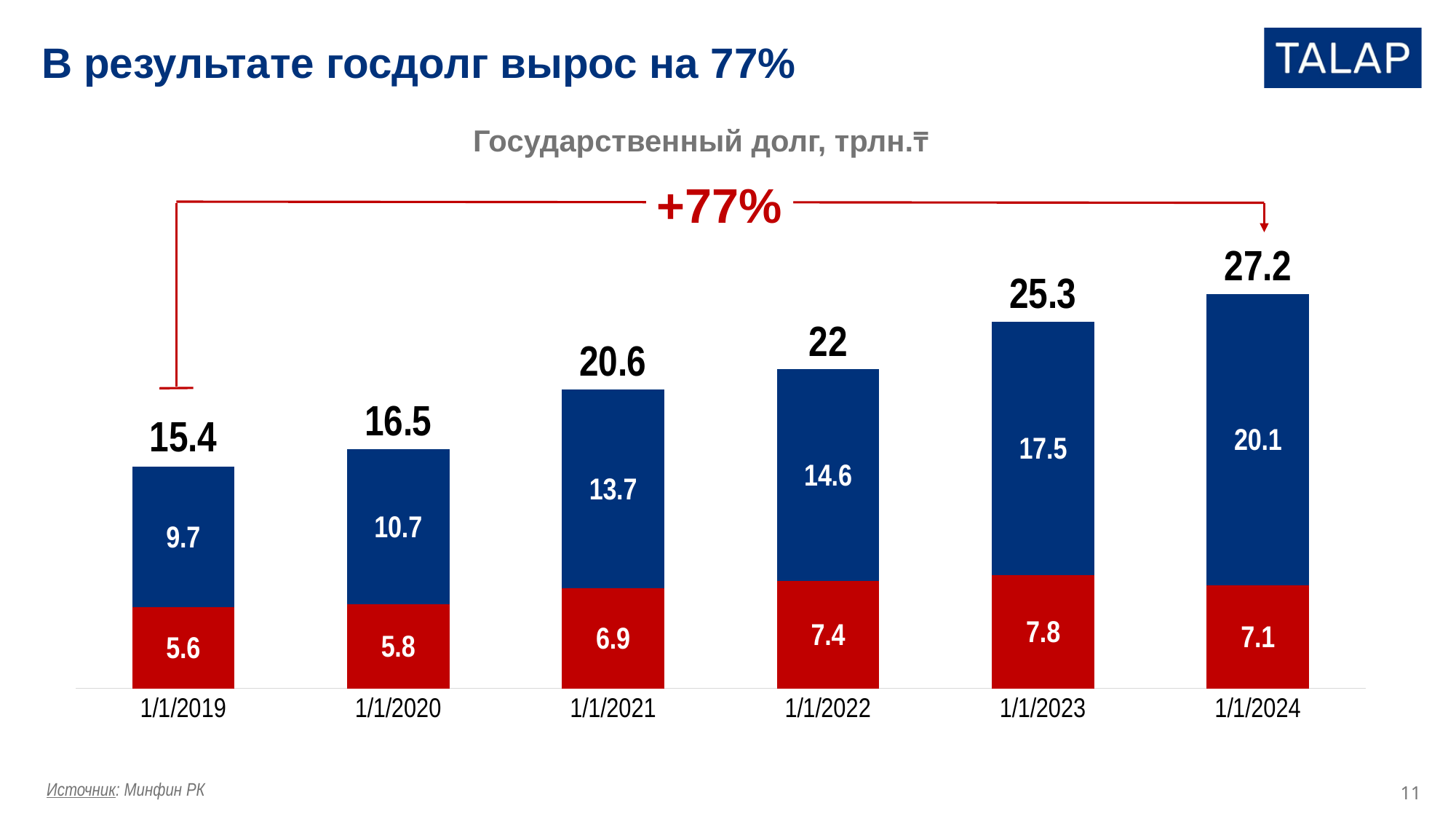
What is the title of the chart? Государственный долг, трлн.₸ Which is larger, the red segment for 1/1/2023 or the red segment for 1/1/2024? 1/1/2023 How many dates are shown on the x axis? 6 What is the value of the blue segment for 1/1/2021? 13.7 Which date has the lowest total government debt? 1/1/2019 Do the total values rise or fall from 1/1/2019 to 1/1/2024? Rise Which date has the highest total government debt? 1/1/2024 What kind of chart is shown on the slide? Stacked bar chart What is the value of the red segment for 1/1/2023? 7.8 What is the difference between the total for 1/1/2024 and the total for 1/1/2019? 11.8 What percentage increase is annotated in red above the chart? +77% What is the total government debt shown for 1/1/2024? 27.2